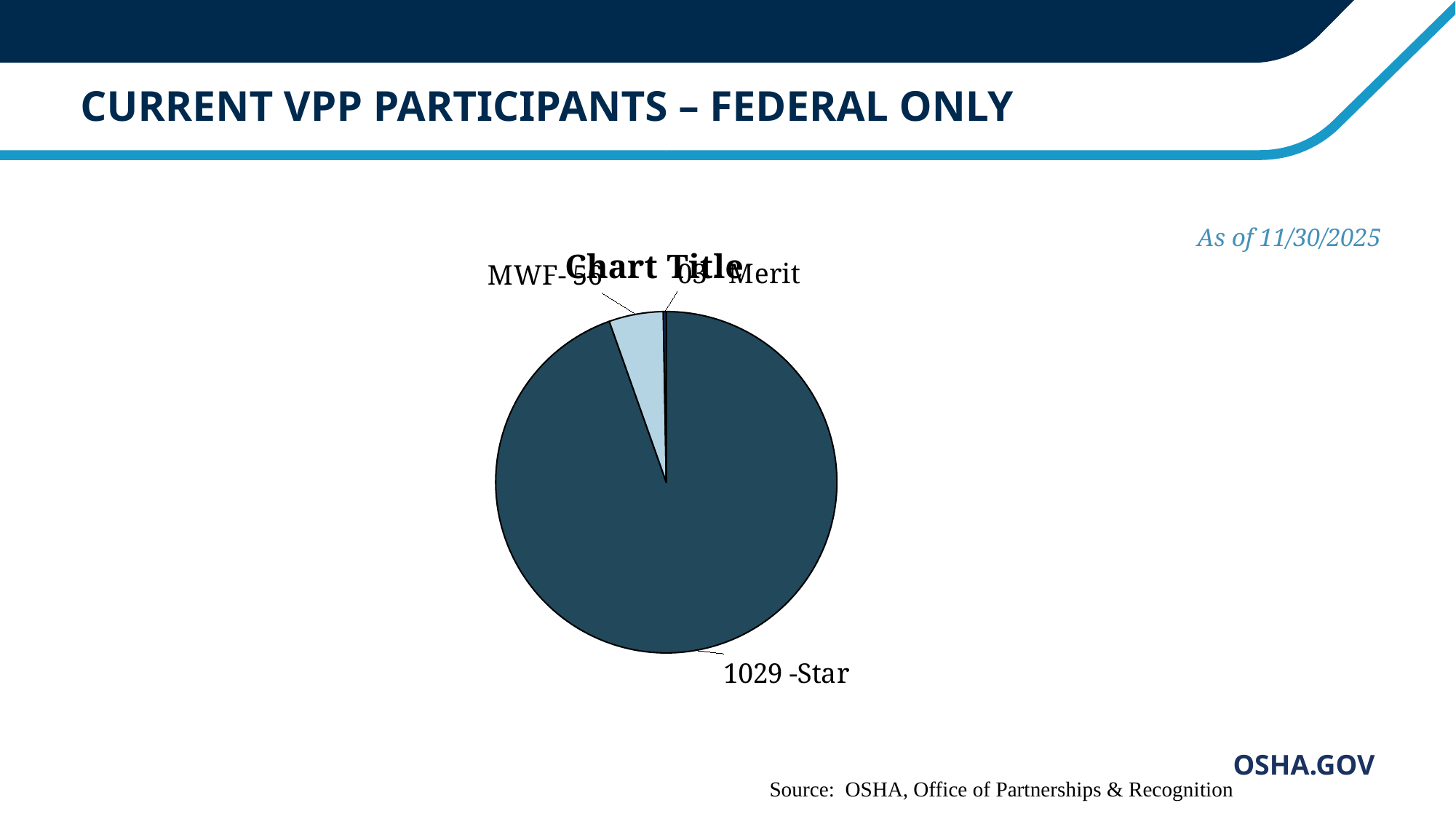
Which slice is larger, Star or MWF? Star What date is the chart data stated to be current as of? 11/30/2025 What is the value shown for the Star slice? 1029 How many slices does the pie chart have? 3 What kind of chart is shown on the slide? pie chart What is the title printed above the pie chart? Chart Title Which category has the smallest slice of the pie? Merit Which slice is larger, MWF or Merit? MWF Which category has the largest slice of the pie? Star